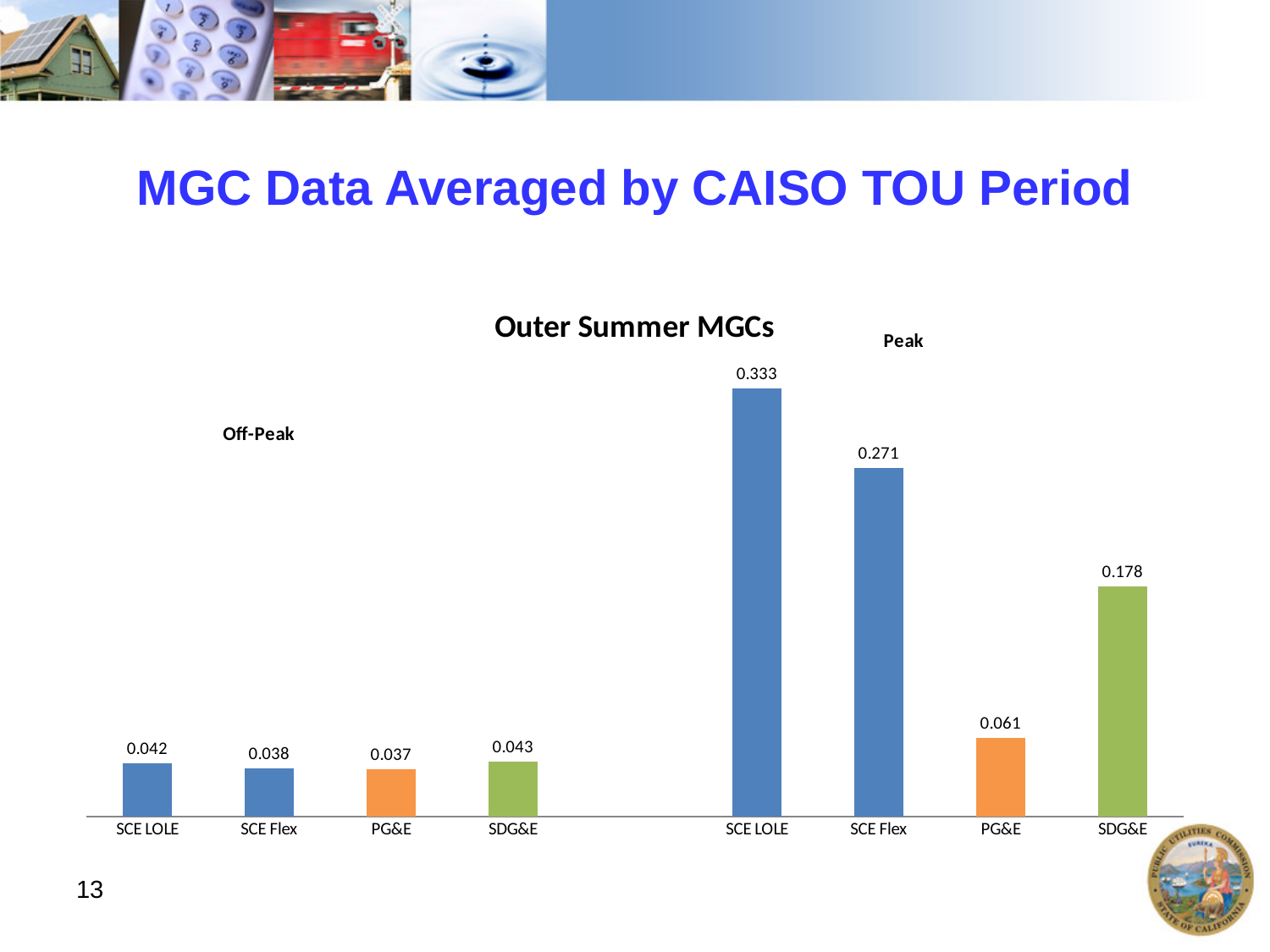
Which category has the lowest Off-Peak value? PG&E Which is larger, the Peak value for SDG&E or the Peak value for PG&E? SDG&E What is the Peak value for SDG&E? 0.178 What is the difference between the Peak values for SCE LOLE and SCE Flex? 0.062 Which category has the highest Peak value? SCE LOLE What are the two TOU period groups labelled in the chart? Off-Peak and Peak What type of chart is shown on the slide? Bar chart What is the Off-Peak value for SCE LOLE? 0.042 What is the Peak value for PG&E? 0.061 What is the title of the chart? Outer Summer MGCs How many bars are plotted in the chart in total? 8 What is the difference between the Off-Peak values for SDG&E and PG&E? 0.006